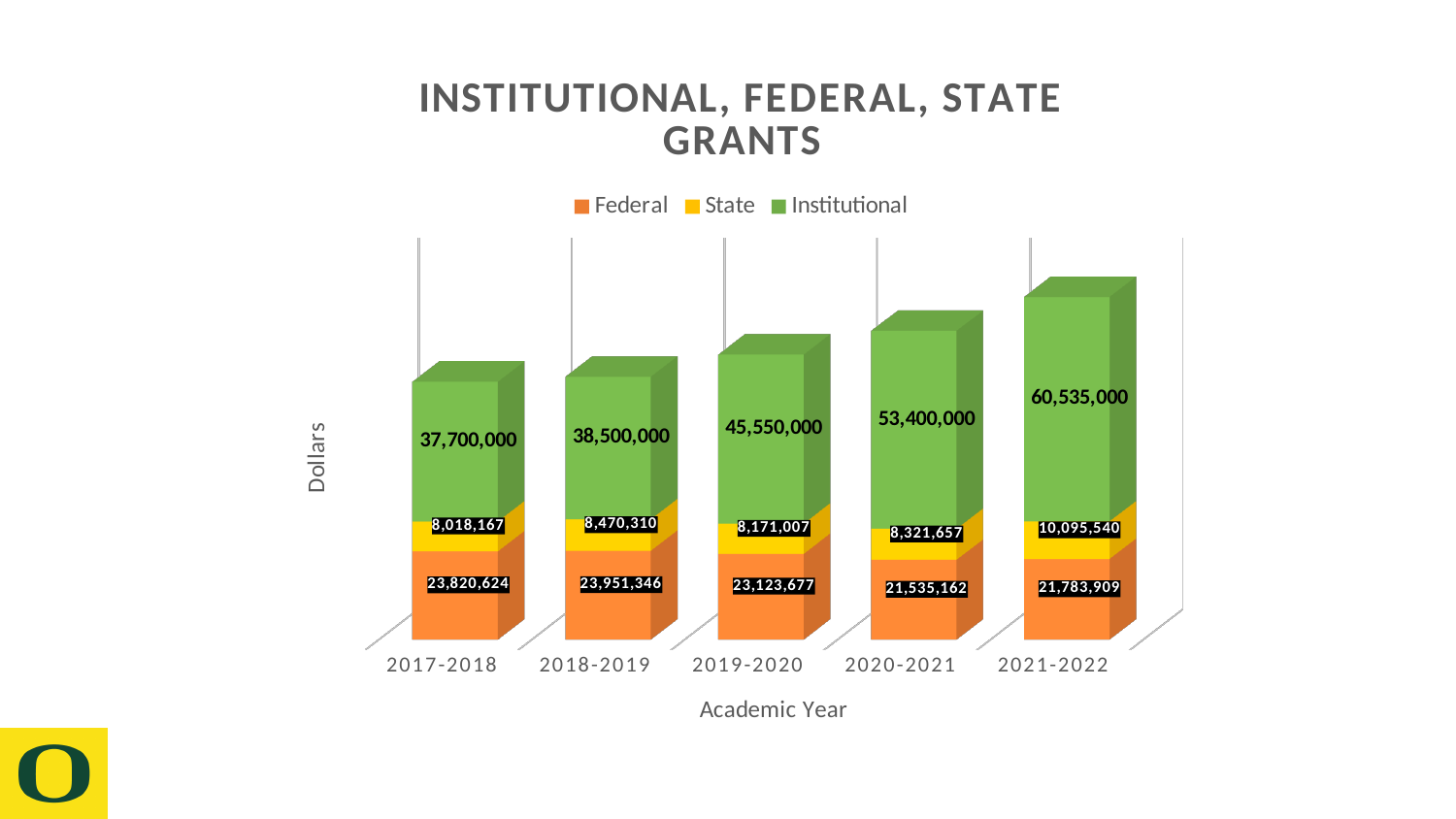
Which is larger, the State grant value for 2021-2022 or for 2018-2019? 2021-2022 What is the total of the stacked bar for 2021-2022? 92,414,449 What is the Institutional grant value for 2021-2022? 60,535,000 Which academic year has the lowest Federal grant value? 2020-2021 Which academic year has the highest Institutional grant value? 2021-2022 What is the Federal grant value for 2017-2018? 23,820,624 What is the difference between the Institutional grant values for 2021-2022 and 2017-2018? 22,835,000 What kind of chart is shown on the slide? Stacked bar chart Do the Institutional grant values rise or fall from 2017-2018 to 2021-2022? Rise How many academic years are shown on the x axis? 5 What is the State grant value for 2019-2020? 8,171,007 How many series does the legend list? 3